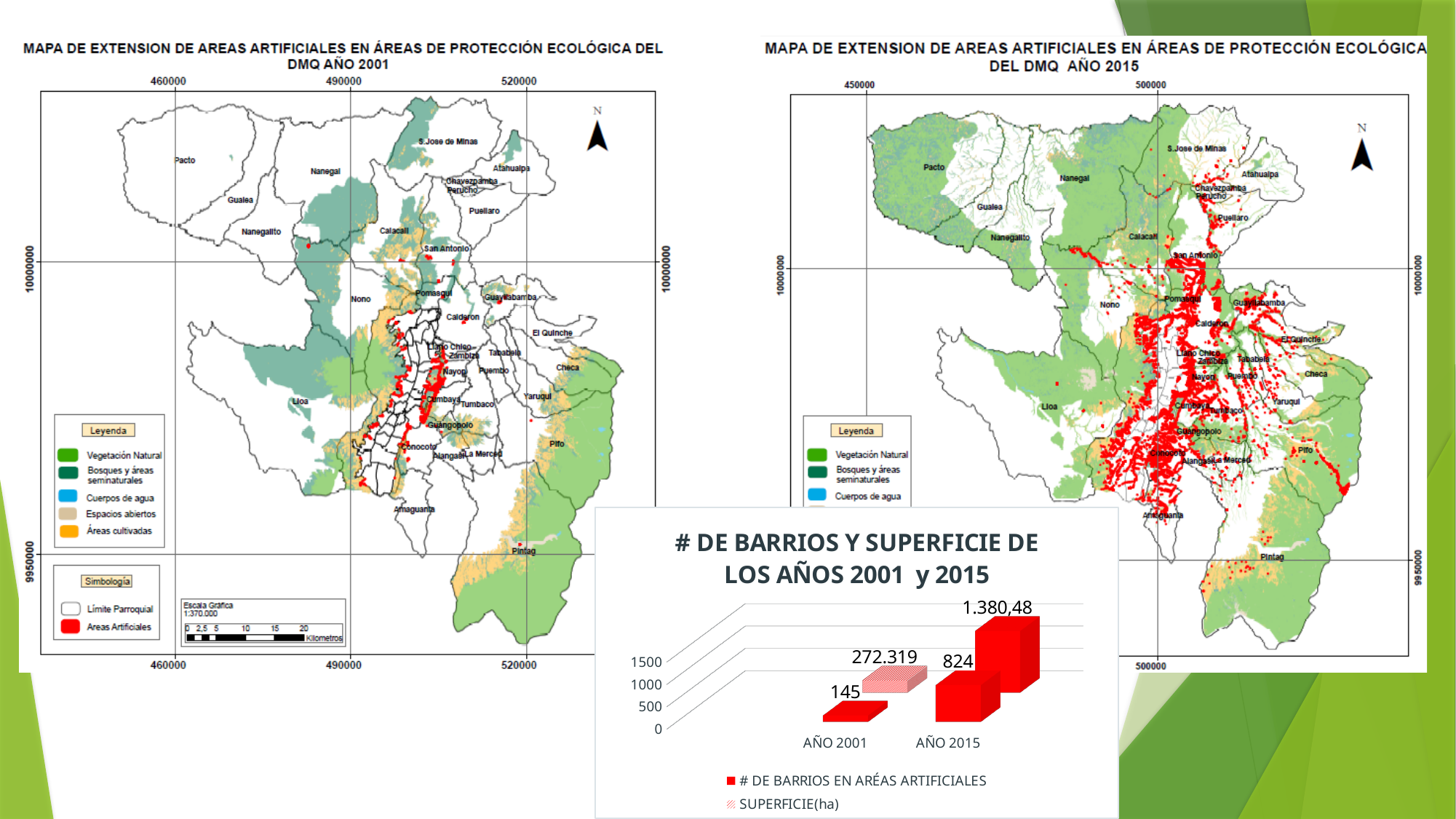
How many series does the legend of the bar chart at the bottom of the slide list? 2 In the chart titled '# DE BARRIOS Y SUPERFICIE DE LOS AÑOS 2001 y 2015', what is the SUPERFICIE(ha) value for AÑO 2015? 1.380,48 In the chart titled '# DE BARRIOS Y SUPERFICIE DE LOS AÑOS 2001 y 2015', what is the value for # DE BARRIOS EN ARÉAS ARTIFICIALES in AÑO 2015? 824 In the bar chart at the bottom of the slide, is the # DE BARRIOS EN ARÉAS ARTIFICIALES value for AÑO 2001 greater or less than 500? less In the bar chart at the bottom of the slide, which year has the higher number of barrios en áreas artificiales? AÑO 2015 In the bar chart at the bottom of the slide, which year has the lower SUPERFICIE(ha) value? AÑO 2001 In the bar chart at the bottom of the slide, is the SUPERFICIE(ha) value for AÑO 2015 greater or less than 1000? greater In the chart titled '# DE BARRIOS Y SUPERFICIE DE LOS AÑOS 2001 y 2015', what is the value for # DE BARRIOS EN ARÉAS ARTIFICIALES in AÑO 2001? 145 What kind of chart is the one titled '# DE BARRIOS Y SUPERFICIE DE LOS AÑOS 2001 y 2015'? Bar chart How many year categories are shown on the x axis of the bar chart at the bottom of the slide? 2 In the bar chart at the bottom of the slide, what is the difference in # DE BARRIOS EN ARÉAS ARTIFICIALES between AÑO 2015 and AÑO 2001? 679 In the chart titled '# DE BARRIOS Y SUPERFICIE DE LOS AÑOS 2001 y 2015', what is the SUPERFICIE(ha) value for AÑO 2001? 272.319